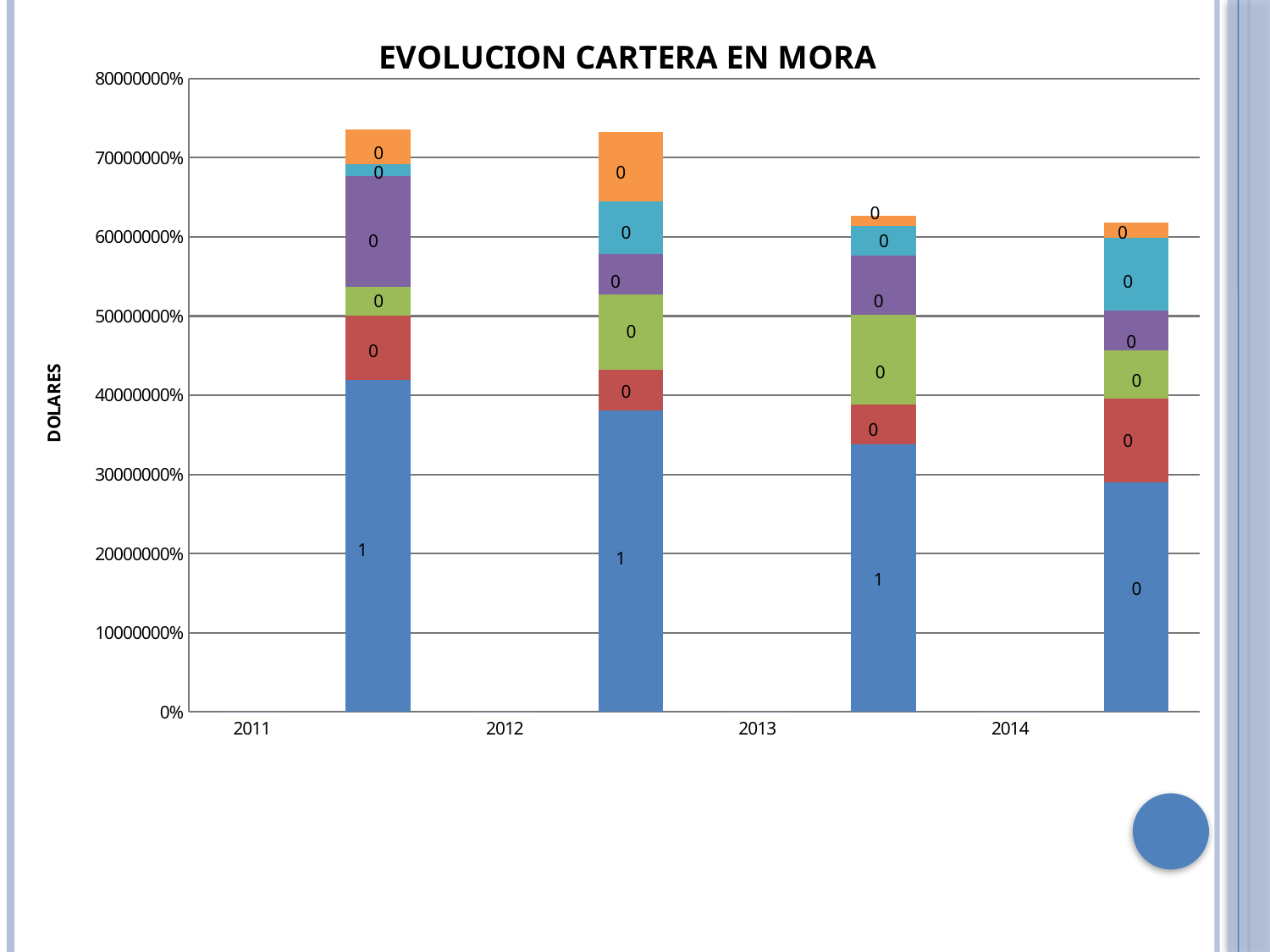
Which year has the larger blue bottom segment, 2011 or 2014? 2011 How many years are shown along the x axis of the chart? 4 How many stacked segments make up each bar in the chart? 6 Do the total bar heights generally rise or fall from 2011 to 2014? fall What type of chart is shown on the slide? Stacked bar chart What is the label on the vertical axis of the chart? DOLARES Is the blue bottom segment of the 2011 bar greater or less than 40000000%? greater What is the title of the chart? EVOLUCION CARTERA EN MORA Is the total height of the 2013 bar greater or less than 70000000%? less Is the blue bottom segment of the 2012 bar greater or less than 40000000%? less Which bar has the larger total, 2011 or 2013? 2011